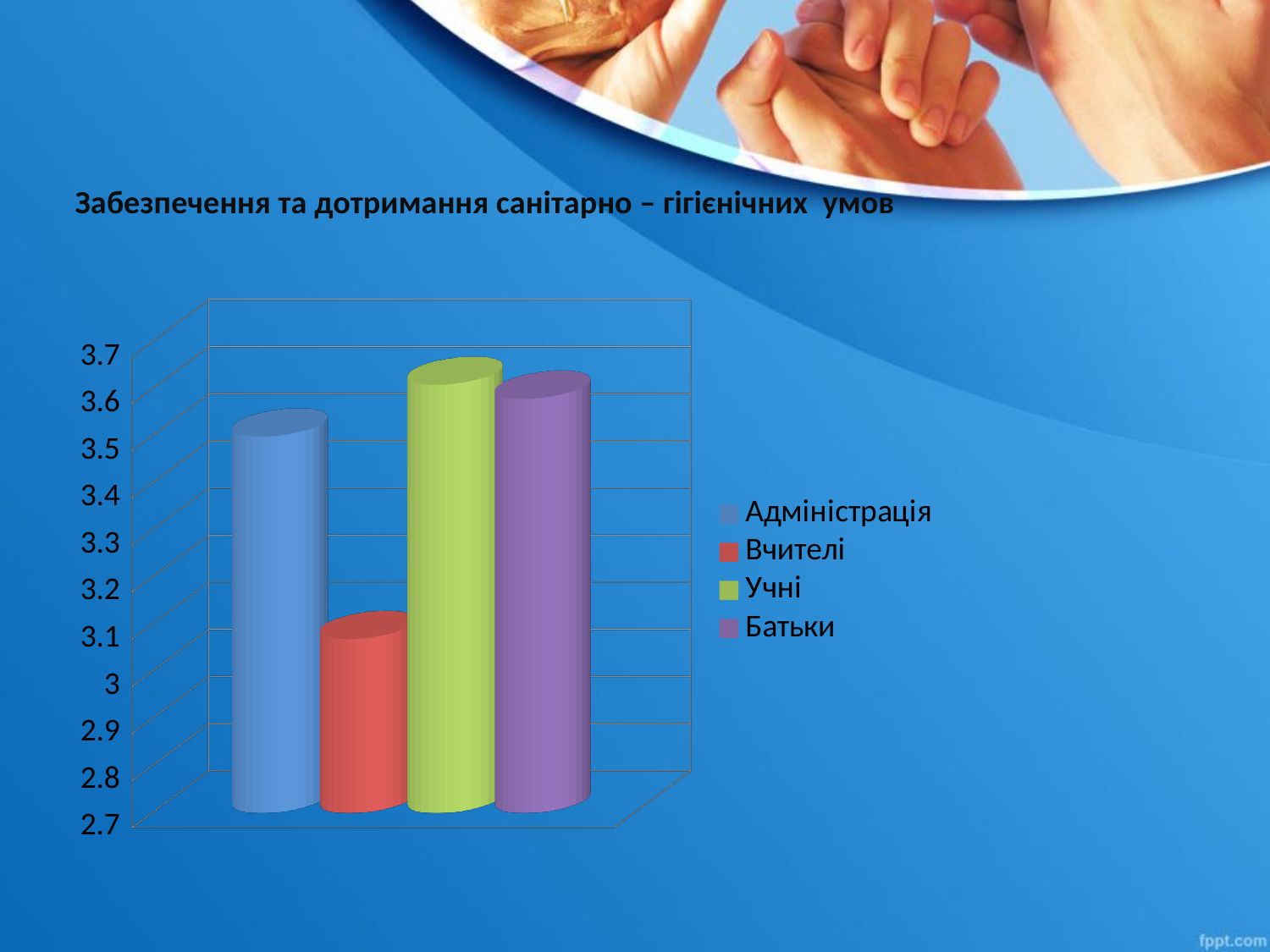
What kind of chart is shown on the slide? bar chart Which is larger, the value for Учні or the value for Вчителі? Учні How many series does the legend list? 4 How many bars are plotted in the chart? 4 What is the title of the chart on the slide? Забезпечення та дотримання санітарно – гігієнічних умов What colour is the bar for Учні? green Which is larger, the value for Адміністрація or the value for Вчителі? Адміністрація Is the value for Учні greater or less than 3.4? greater Is the value for Батьки greater or less than 3.4? greater Is the value for Вчителі greater or less than 3.3? less Which group has the lowest value in the chart? Вчителі